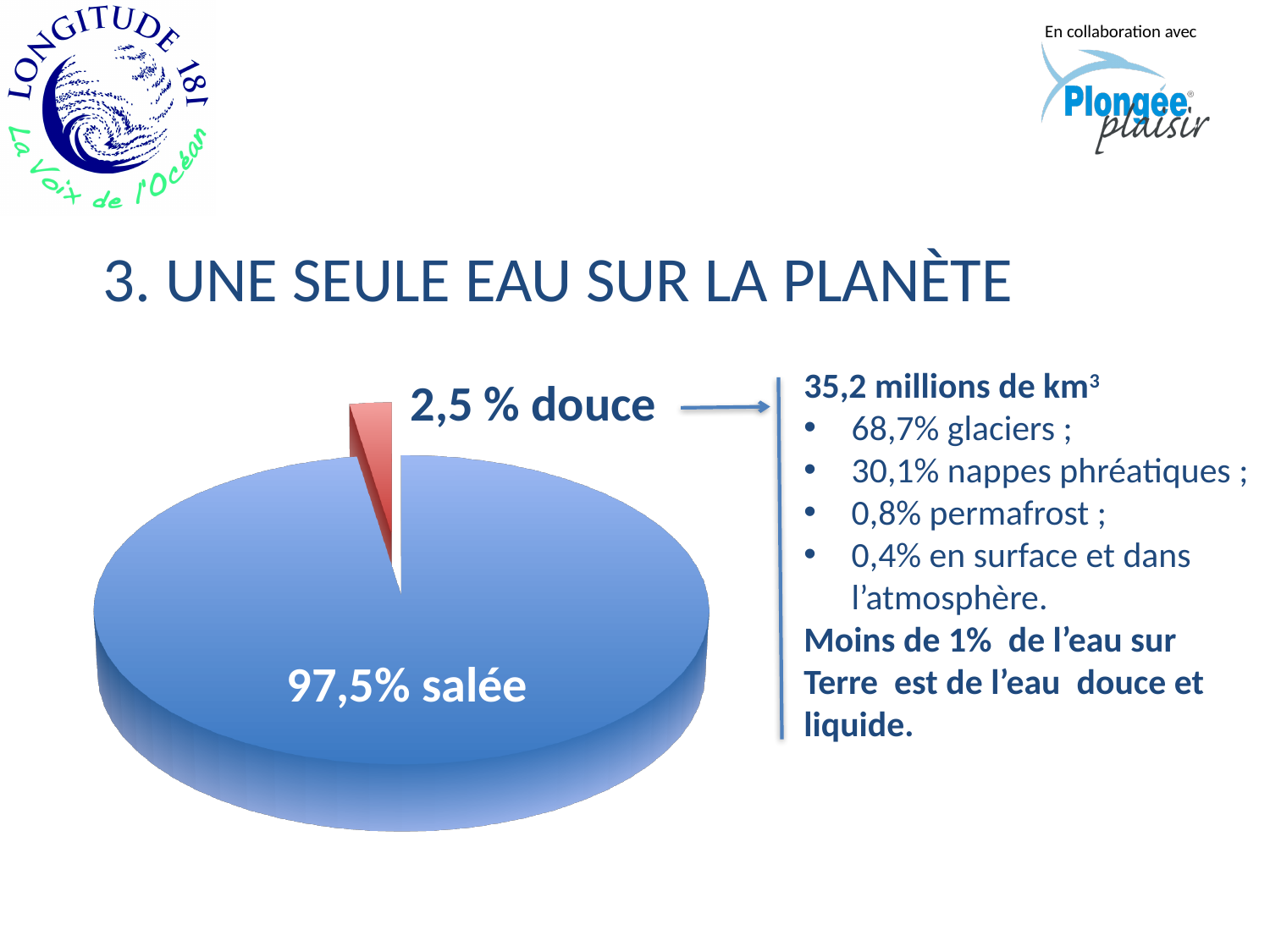
Which slice of the pie chart is the smallest? douce What percentage of the pie chart is labelled "douce"? 2,5 % Which slice of the pie chart is the largest? salée What kind of chart is shown on the slide? pie chart What colour is the "douce" slice in the pie chart? red What is the difference in percentage points between the "salée" slice and the "douce" slice? 95 What percentage of the pie chart is labelled "salée"? 97,5% Which is larger in the pie chart, the "salée" slice or the "douce" slice? salée What share of the pie does the "douce" slice represent? 2,5 % What colour is the "salée" slice in the pie chart? blue How many slices does the pie chart have? 2